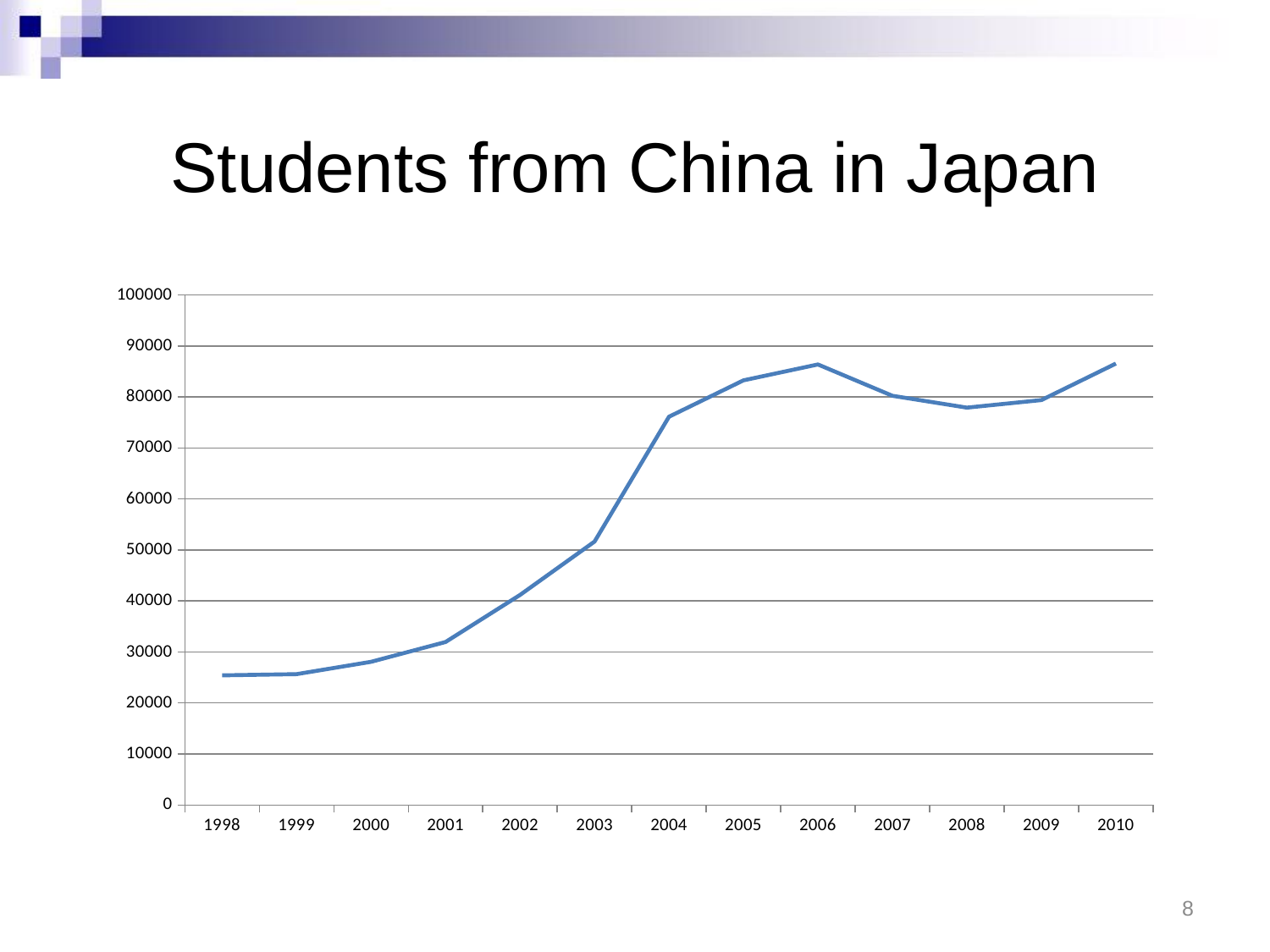
What kind of chart is shown on the slide? line chart Is the value for 2002 greater or less than 30000? greater Is the value for 1998 greater or less than 30000? less How many years are plotted along the x axis of the chart? 13 Which year has the larger value, 2006 or 2008? 2006 What is the highest value shown on the y axis of the chart? 100000 Is the value for 2003 greater or less than 60000? less Which year has the larger value, 2003 or 2004? 2004 What is the title of the chart on the slide? Students from China in Japan Do the values generally rise or fall from 1998 to 2006? rise